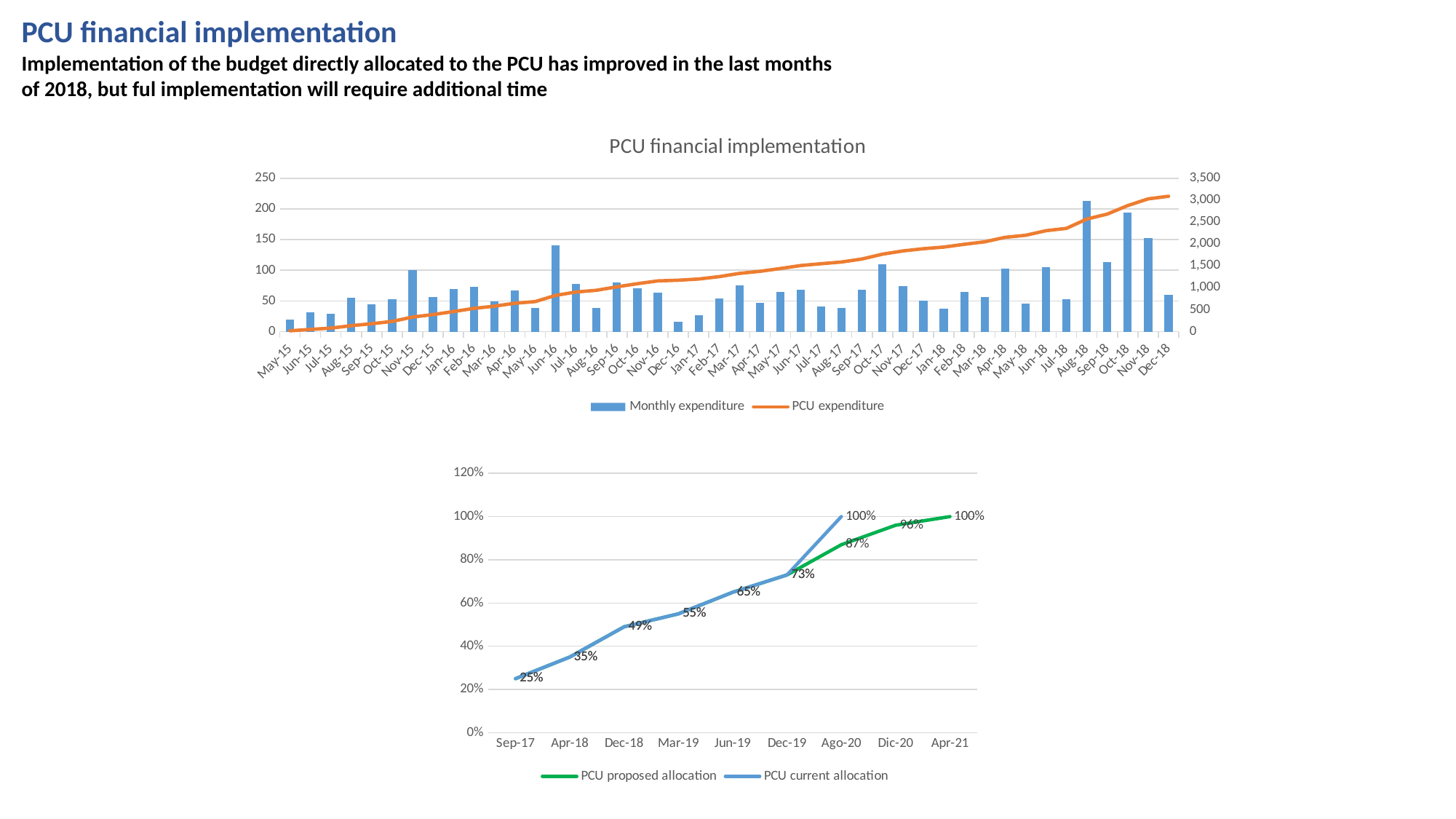
In the top chart, which month has the highest monthly expenditure bar? Aug-18 In the bottom chart, what is the difference between the values labelled at Jun-19 and Dec-18? 16% In the top chart, is the monthly expenditure for Aug-18 greater or less than 200? greater In the bottom chart, how many categories are shown on the x axis? 9 In the bottom chart, what is the PCU proposed allocation value labelled at Dic-20? 96% In the top chart, does the PCU expenditure line rise or fall from May-15 to Dec-18? rise In the top chart, how many series does the legend list? 2 In the bottom chart, what is the value labelled at Dec-19? 73% In the bottom chart, what is the value labelled at Sep-17? 25% In the top chart, which month has the lowest monthly expenditure bar? Dec-16 In the bottom chart, which series reaches 100% at Ago-20? PCU current allocation In the top chart, is the monthly expenditure for Jun-16 greater or less than 100? greater